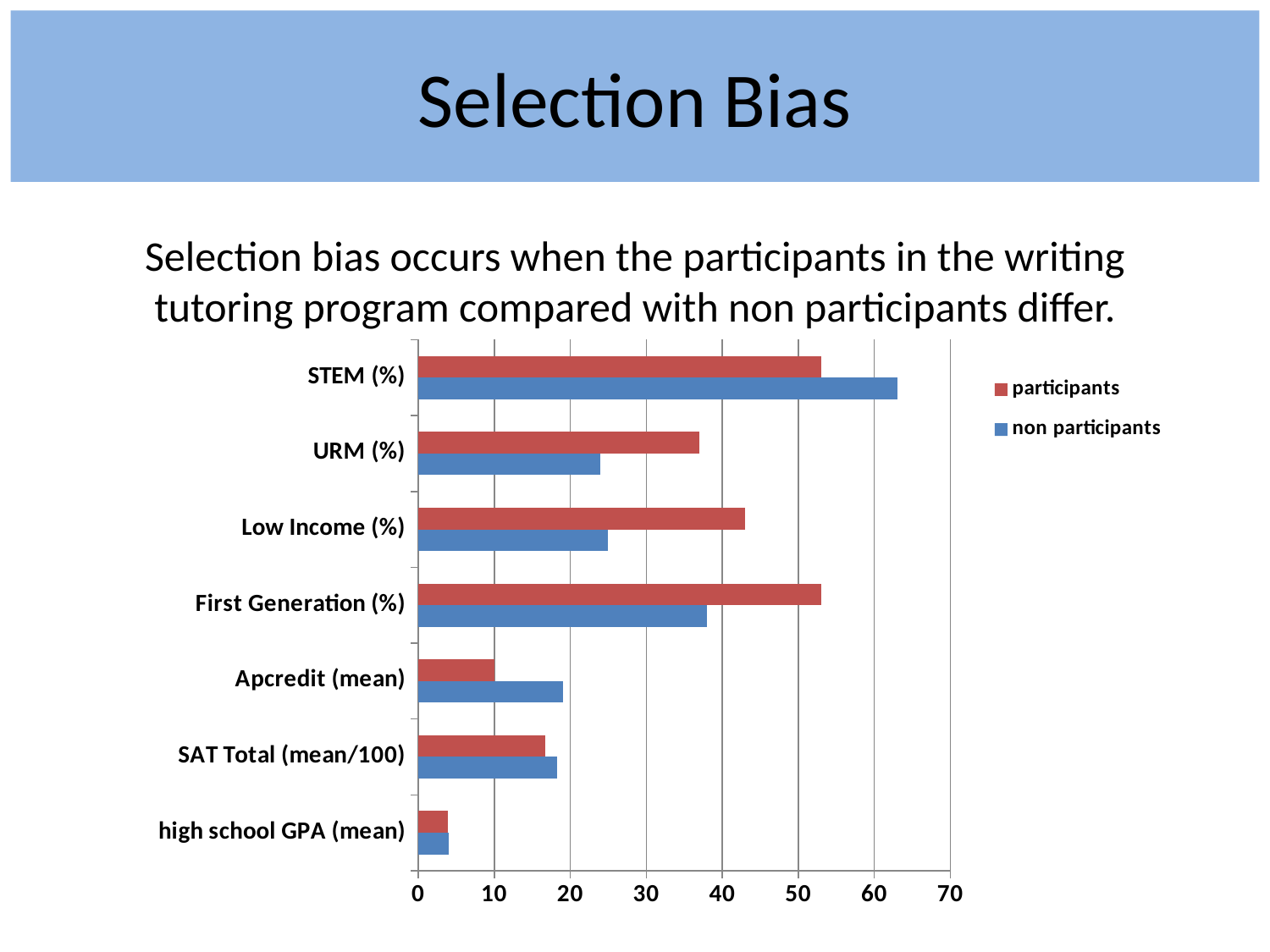
Which category has the highest value for non participants? STEM (%) Is the value for participants in URM (%) greater or less than 30? greater For STEM (%), which series has the larger value, participants or non participants? non participants Which series is shown in blue? non participants How many categories are plotted on the chart? 7 Which category has the lowest value for participants? high school GPA (mean) What kind of chart is shown on the slide? bar chart Is the value for non participants in Low Income (%) greater or less than 30? less Is the value for participants in Apcredit (mean) greater or less than 20? less How many series does the legend list? 2 For First Generation (%), which series has the larger value, participants or non participants? participants